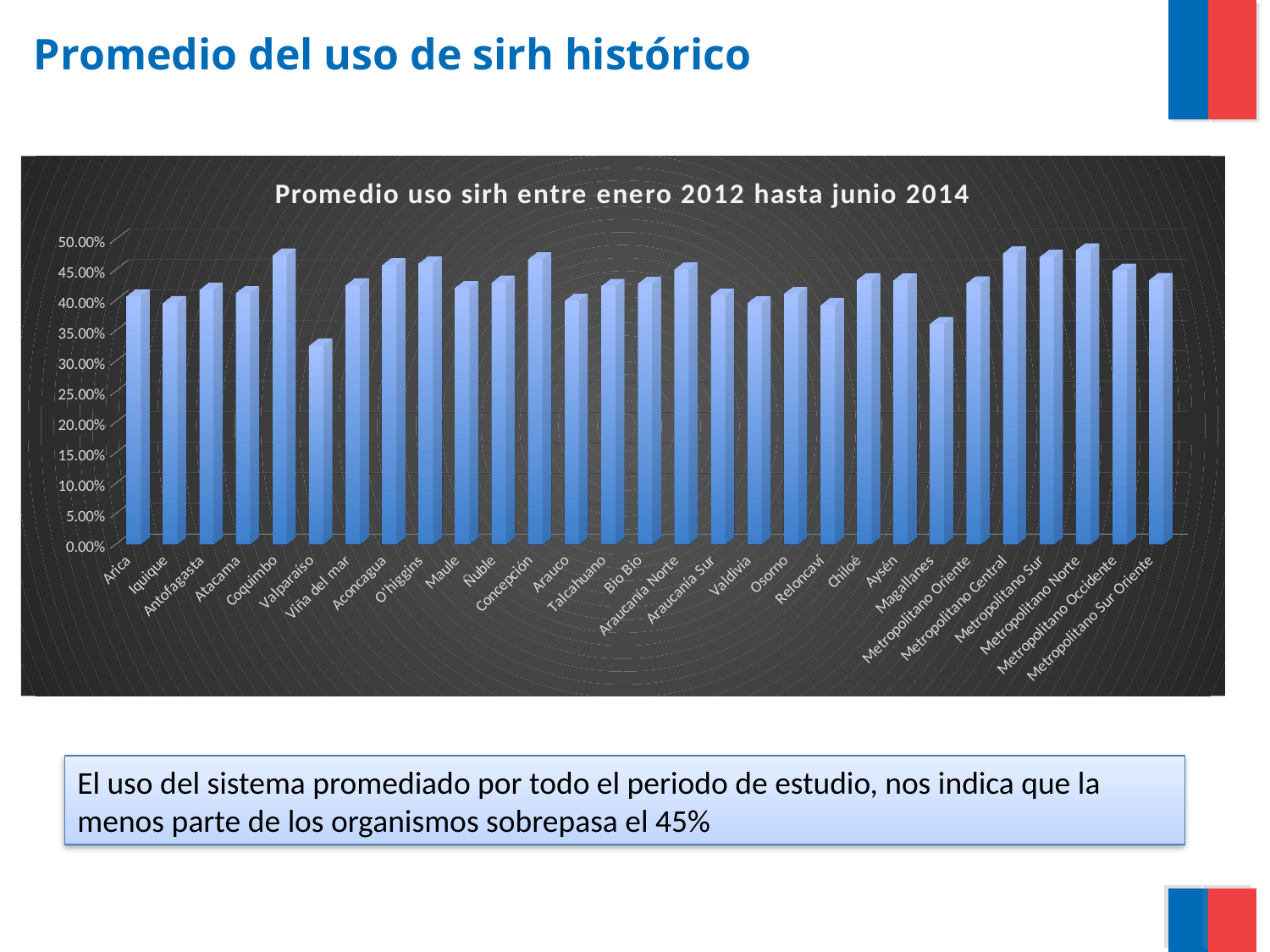
Which category has the lowest value in the chart? Valparaíso Which has a larger value, Valparaíso or Coquimbo? Coquimbo Which has a larger value, Magallanes or Metropolitano Central? Metropolitano Central Is the value for Concepción greater or less than 45.00%? greater Is the value for Magallanes greater or less than 40.00%? less What is the title of the chart? Promedio uso sirh entre enero 2012 hasta junio 2014 Is the value for Coquimbo greater or less than 45.00%? greater What kind of chart is shown on the slide? bar chart How many categories (organisms) are plotted on the x axis of the chart? 29 What is the highest value shown on the y axis of the chart? 50.00%